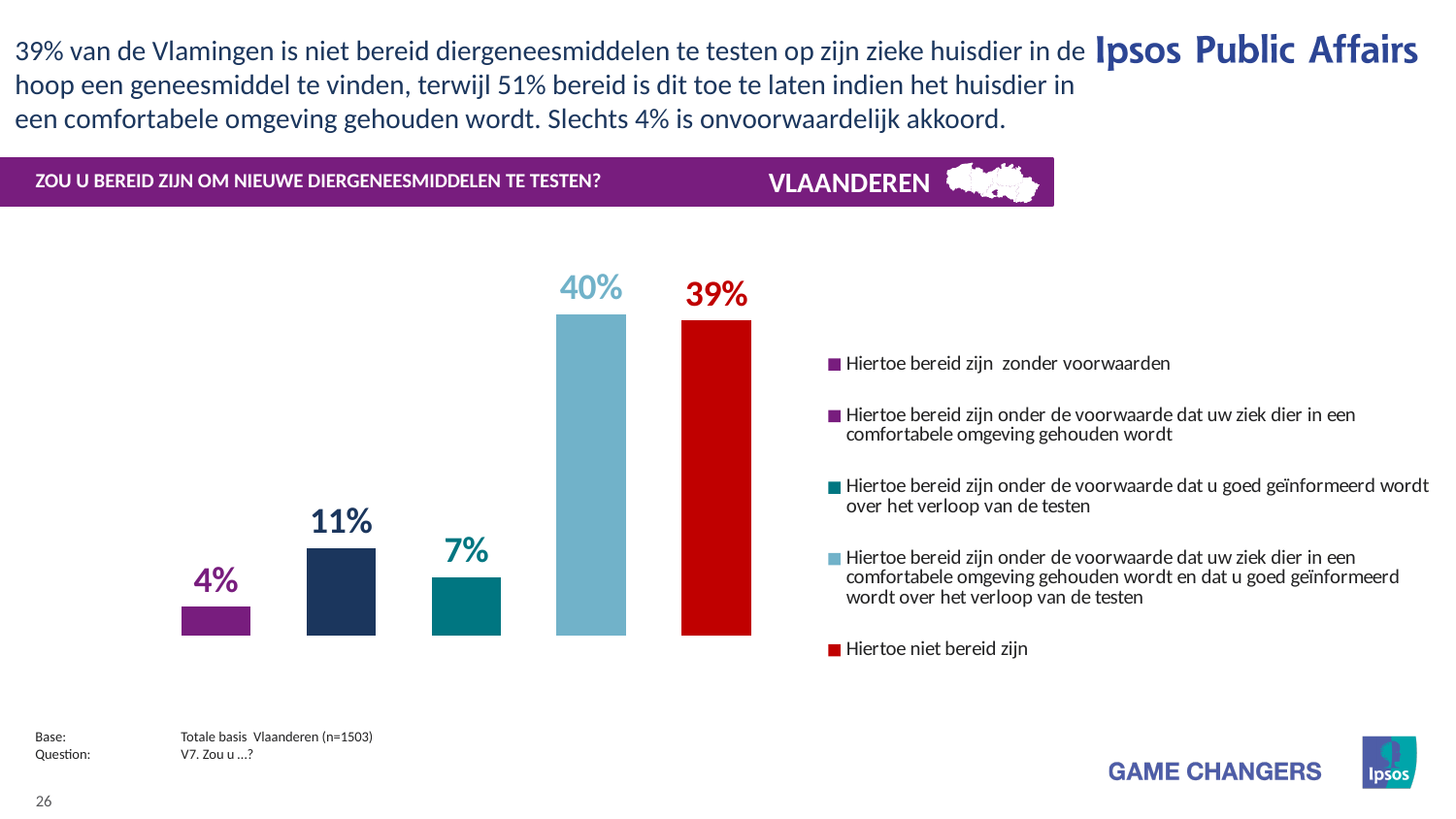
What is the difference between the 11% bar and the 7% bar? 4% Which is larger: the value for willing without conditions or the value for willing on the condition of being well informed? Willing on the condition of being well informed (7%) How many entries does the legend list? 5 What is the difference between the highest bar (40%) and the 'Hiertoe niet bereid zijn' bar (39%)? 1% What percentage of respondents are 'Hiertoe niet bereid zijn' (not willing)? 39% Which category has the highest value in the chart? Hiertoe bereid zijn onder de voorwaarde dat uw ziek dier in een comfortabele omgeving gehouden wordt en dat u goed geïnformeerd wordt over het verloop van de testen (40%) What value is shown for the bar representing willingness on the condition that the sick animal is kept in a comfortable environment? 11% What type of chart is shown on the slide? Bar chart How many bars are plotted in the chart? 5 What value is shown for the bar representing willingness on the condition of being well informed about the course of the tests? 7% Which category has the lowest value in the chart? Hiertoe bereid zijn zonder voorwaarden (4%) What percentage of respondents are willing without conditions ('Hiertoe bereid zijn zonder voorwaarden')? 4%